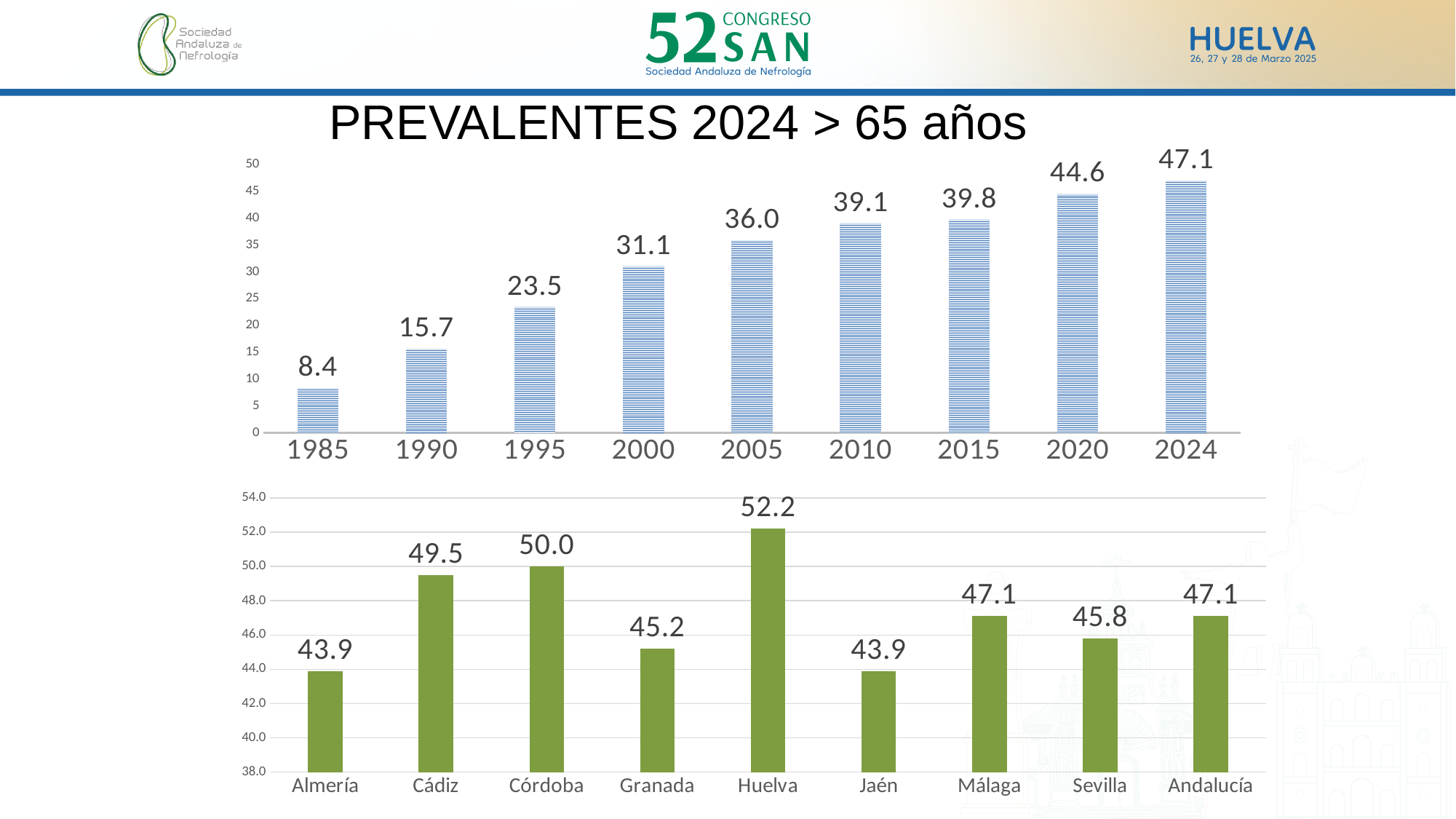
In the top chart (by year), which year has the highest value? 2024 In the bottom chart (by province), what is the value for Huelva? 52.2 In the bottom chart (by province), what is the value for Andalucía? 47.1 In the top chart (by year), what is the value for 2024? 47.1 What kind of chart is the bottom chart (by province)? bar chart In the top chart (by year), what is the difference between the values for 2024 and 1985? 38.7 In the bottom chart (by province), which is larger, the value for Cádiz or the value for Granada? Cádiz In the top chart (by year), do the values rise or fall from 1985 to 2024? rise In the bottom chart (by province), what is the difference between the values for Huelva and Jaén? 8.3 In the top chart (by year), what is the value for 1985? 8.4 In the bottom chart (by province), which province has the highest value? Huelva In the top chart (by year), how many years are plotted? 9